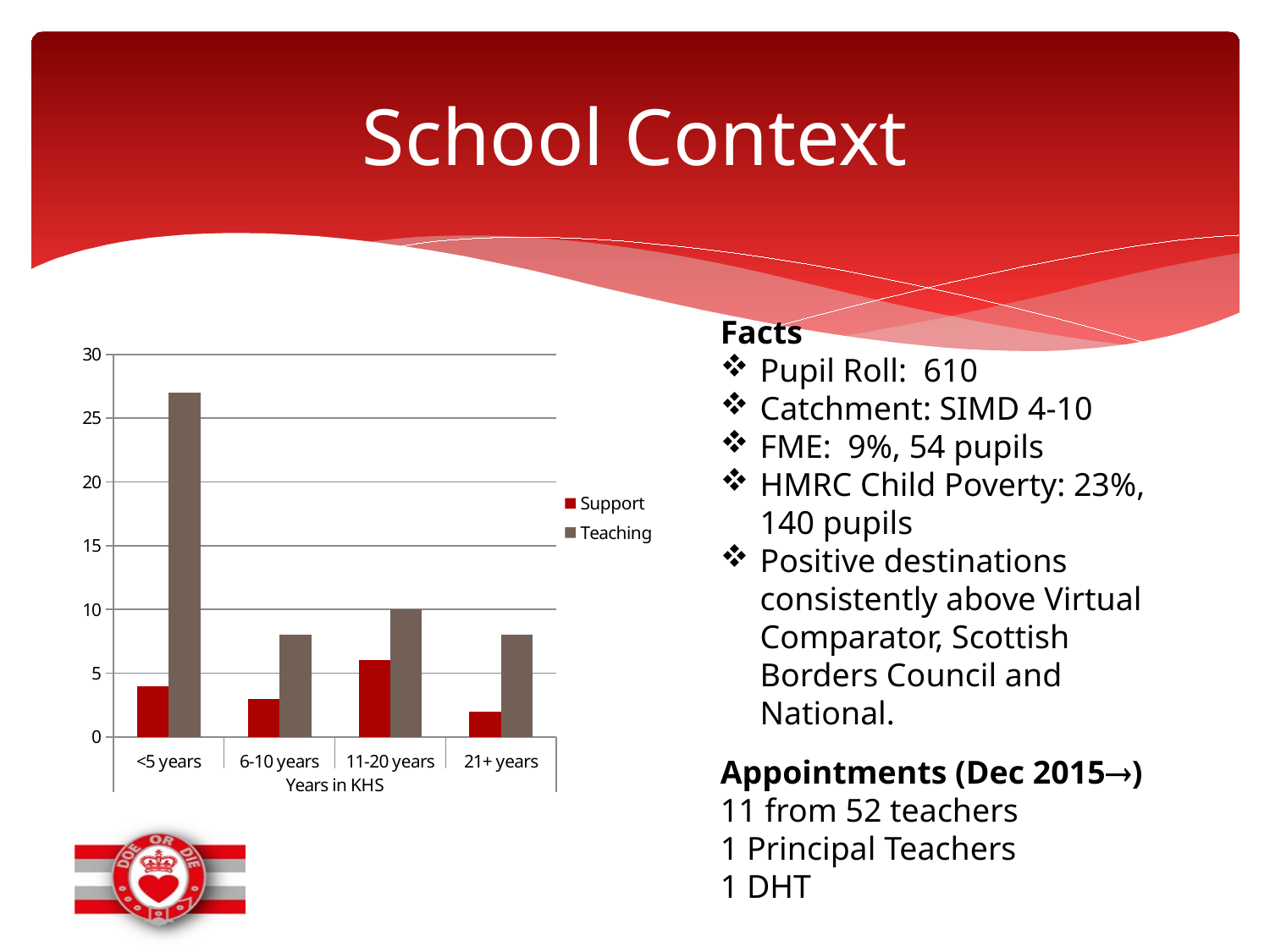
For <5 years, which is larger, Support or Teaching? Teaching How many series does the chart's legend list? 2 What kind of chart is shown on the slide? bar chart What is the title of the chart's x axis? Years in KHS Which category has the highest Teaching value? <5 years Which category has the highest Support value? 11-20 years Is the Teaching value for 6-10 years greater or less than 10? less Is the Teaching value for <5 years greater or less than 25? greater Is the Support value for <5 years greater or less than 5? less Which category has the lowest Support value? 21+ years How many categories are shown along the x axis of the chart? 4